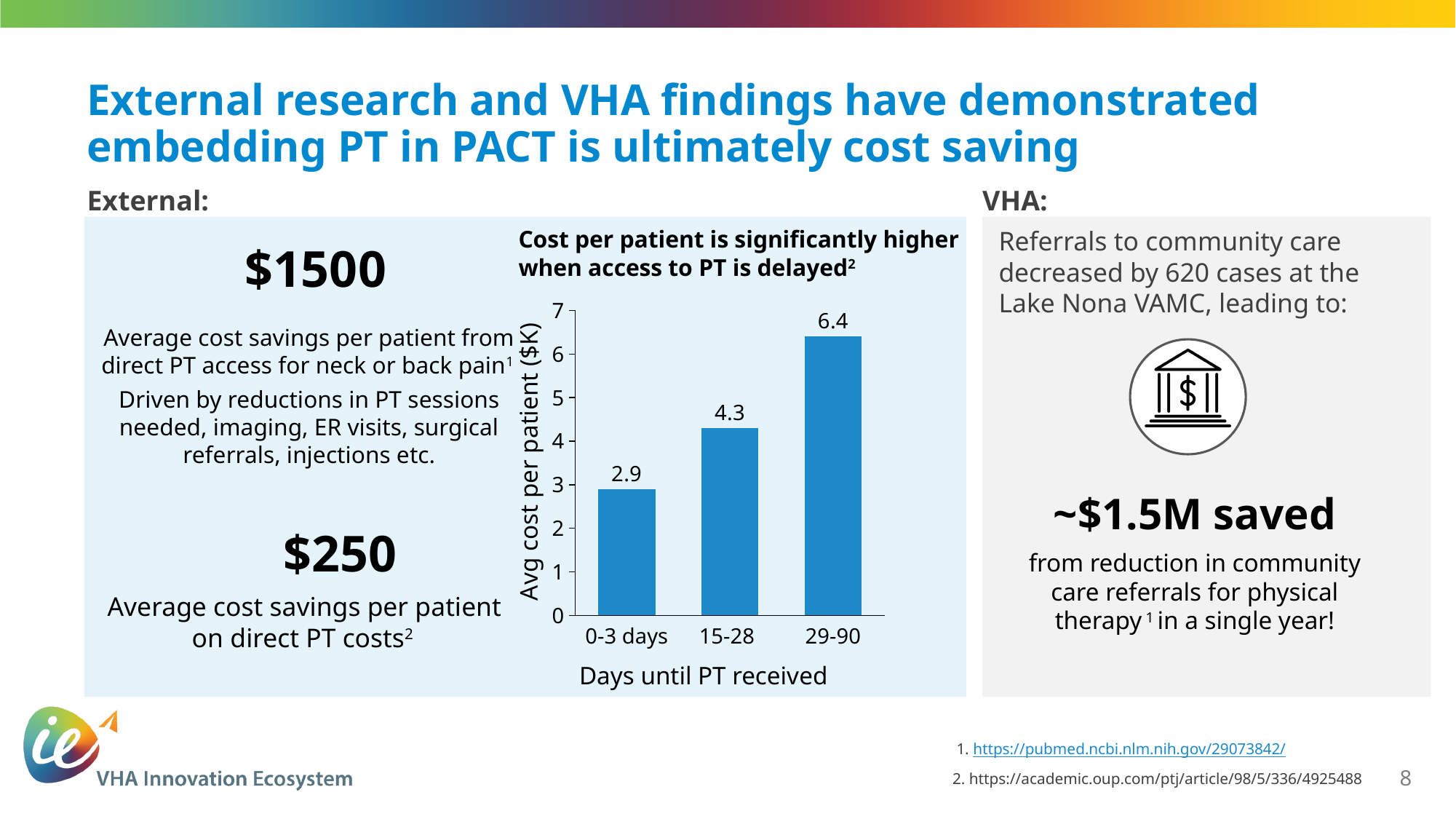
What is the difference in average cost per patient ($K) between the 29-90 days and 0-3 days categories? 3.5 Which has a higher average cost per patient, 15-28 days or 29-90 days? 29-90 How many categories are shown on the x axis of the chart? 3 Which category has the highest average cost per patient? 29-90 Which category has the lowest average cost per patient? 0-3 days What is the average cost per patient ($K) for the 15-28 days category? 4.3 What is the average cost per patient ($K) for the 29-90 days category? 6.4 What is the average cost per patient ($K) for the 0-3 days category? 2.9 What is the label of the y axis of the chart? Avg cost per patient ($K) What is the difference in average cost per patient ($K) between the 15-28 and 0-3 days categories? 1.4 Do the values rise or fall as days until PT received increases? rise What kind of chart is shown on the slide? bar chart